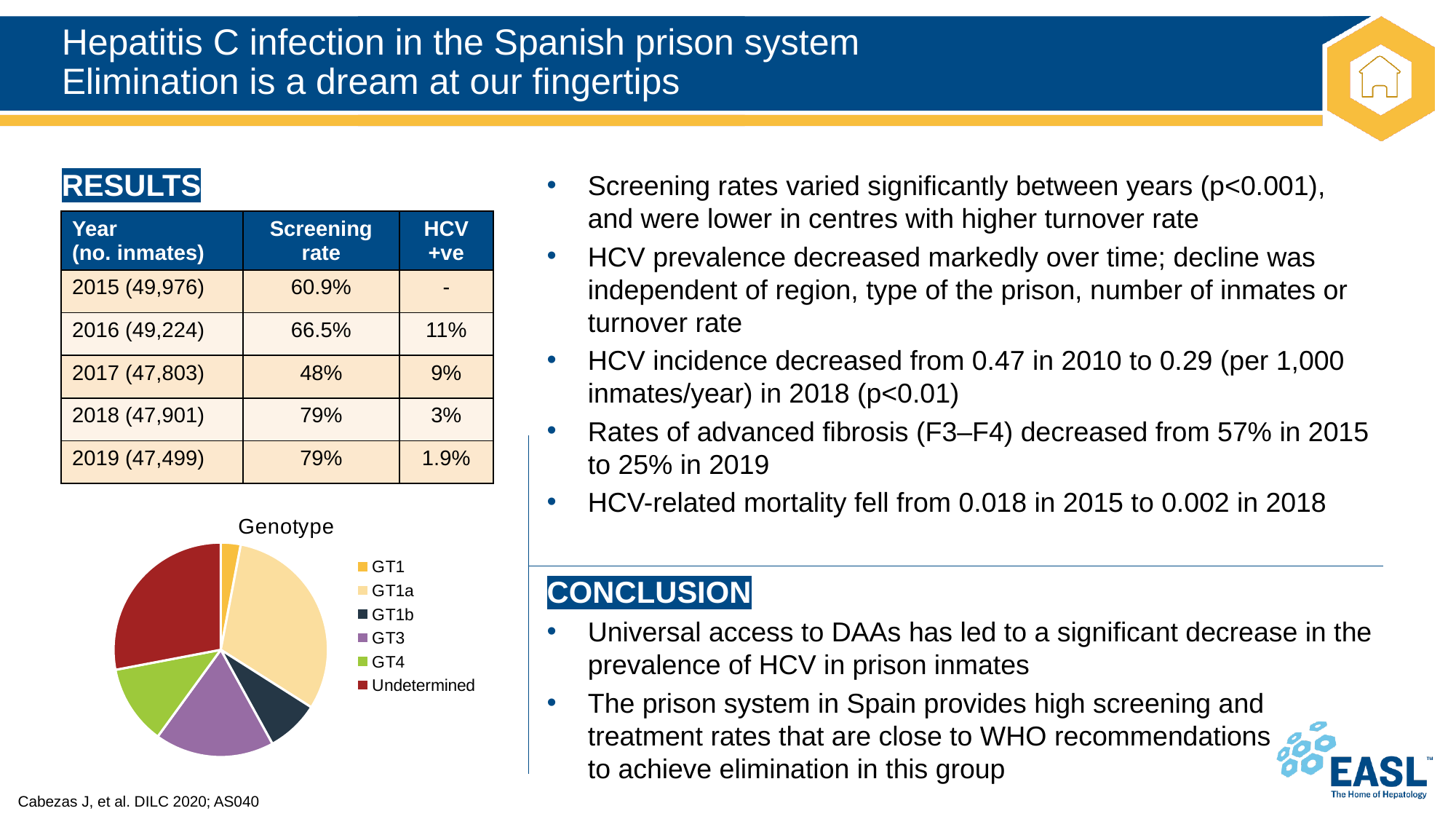
What colour is the Undetermined slice in the Genotype pie chart? dark red Which genotype has the largest slice in the Genotype pie chart? GT1a What kind of chart is the Genotype chart? pie chart In the Genotype pie chart, which slice is larger, GT3 or GT1b? GT3 How many entries does the legend of the Genotype pie chart list? 6 Which genotype has the smallest slice in the Genotype pie chart? GT1 In the Genotype pie chart, which slice is larger, GT4 or GT1? GT4 What is the title of the pie chart? Genotype In the Genotype pie chart, which slice is larger, Undetermined or GT1b? Undetermined How many slices does the Genotype pie chart have? 6